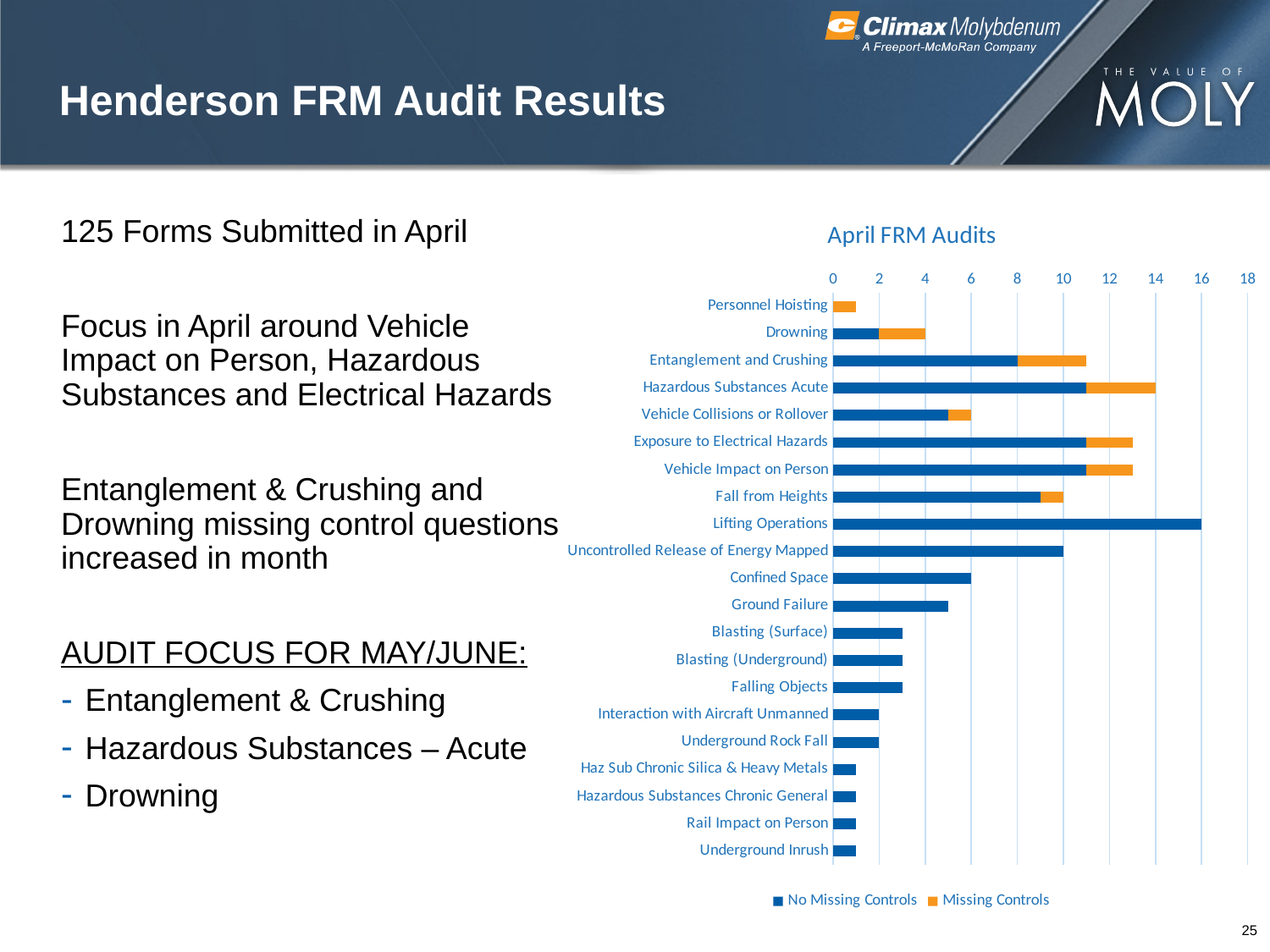
What is the total bar length for Hazardous Substances Acute in the April FRM Audits chart? 14 Is the value for Ground Failure greater or less than 6? less Which series is shown in orange in the chart? Missing Controls What is the title of the chart? April FRM Audits How many categories are plotted in the April FRM Audits chart? 21 What is the value for Lifting Operations in the April FRM Audits chart? 16 What is the value for Uncontrolled Release of Energy Mapped in the April FRM Audits chart? 10 What type of chart is shown on the slide? Stacked bar chart Is the total value for Exposure to Electrical Hazards greater or less than 12? greater How many series does the chart legend list? 2 Which is larger, the bar for Lifting Operations or the bar for Confined Space? Lifting Operations Which category has the longest bar in the April FRM Audits chart? Lifting Operations